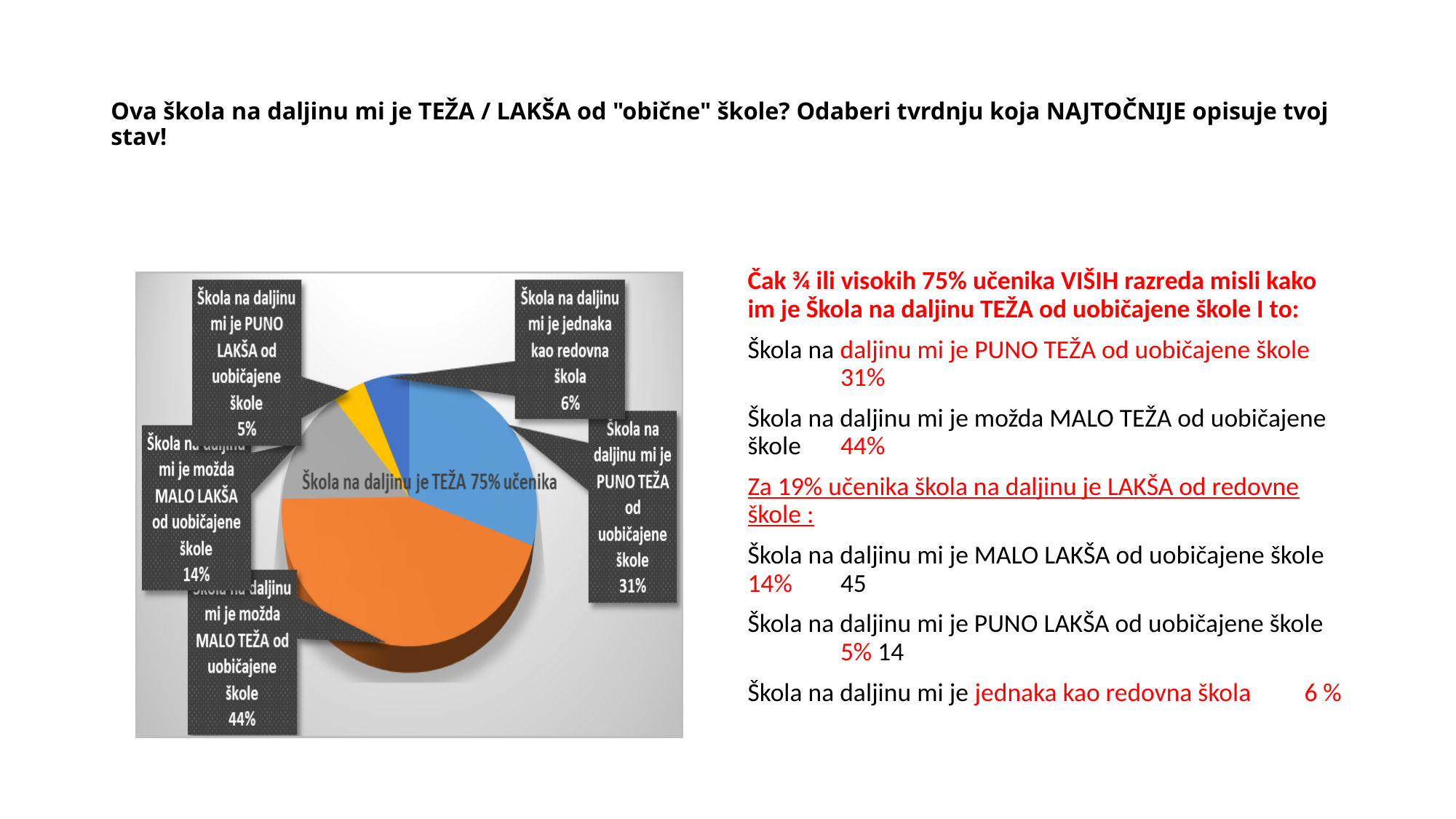
What percentage of students chose "Škola na daljinu mi je PUNO LAKŠA od uobičajene škole"? 5% Which response has the largest share of the pie? Škola na daljinu mi je možda MALO TEŽA od uobičajene škole What percentage of students chose "Škola na daljinu mi je možda MALO LAKŠA od uobičajene škole"? 14% What text is written across the middle of the pie chart? Škola na daljinu je TEŽA 75% učenika Which is larger: the share for "možda MALO LAKŠA" or the share for "jednaka kao redovna škola"? možda MALO LAKŠA How many slices does the pie chart have? 5 Which response has the smallest share of the pie? Škola na daljinu mi je PUNO LAKŠA od uobičajene škole What percentage of students chose "Škola na daljinu mi je PUNO TEŽA od uobičajene škole"? 31% What percentage of students chose "Škola na daljinu mi je možda MALO TEŽA od uobičajene škole"? 44% What percentage of students chose "Škola na daljinu mi je jednaka kao redovna škola"? 6% What is the difference in percentage points between "možda MALO TEŽA" (44%) and "PUNO TEŽA" (31%)? 13 What kind of chart is shown on the slide? pie chart